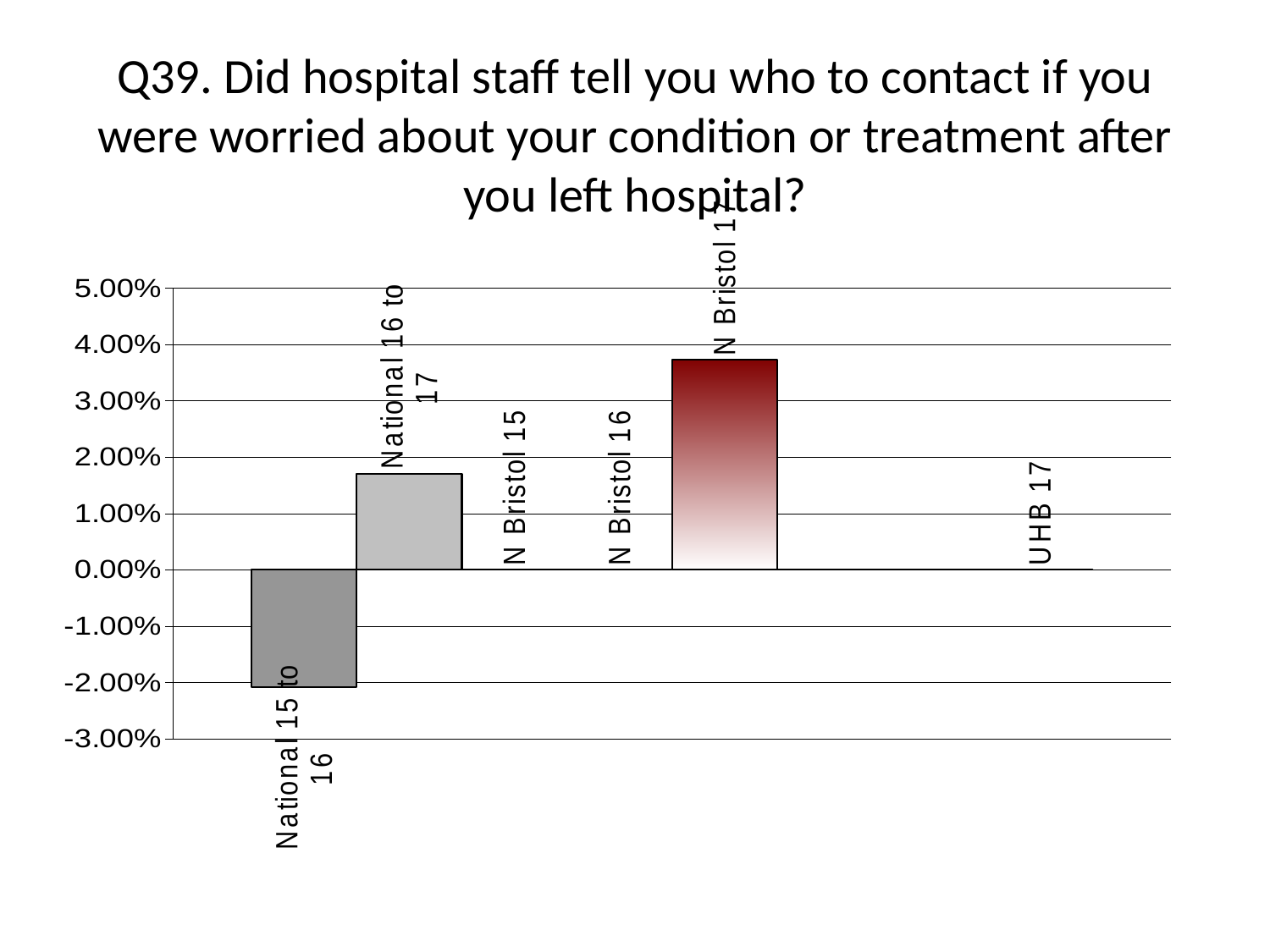
Which is larger, the value for National 16 to 17 or the value for N Bristol 17? N Bristol 17 What kind of chart is shown on the slide? bar chart Which is larger, the value for National 15 to 16 or the value for National 16 to 17? National 16 to 17 Is the value for National 15 to 16 greater or less than -1.00%? less How many categories are labelled on the x axis? 6 Is the value for National 16 to 17 greater or less than 1.00%? greater What is the lowest value shown on the vertical axis? -3.00% Is the value for N Bristol 17 greater or less than 3.00%? greater Which category has the lowest value? National 15 to 16 Which category has the highest value? N Bristol 17